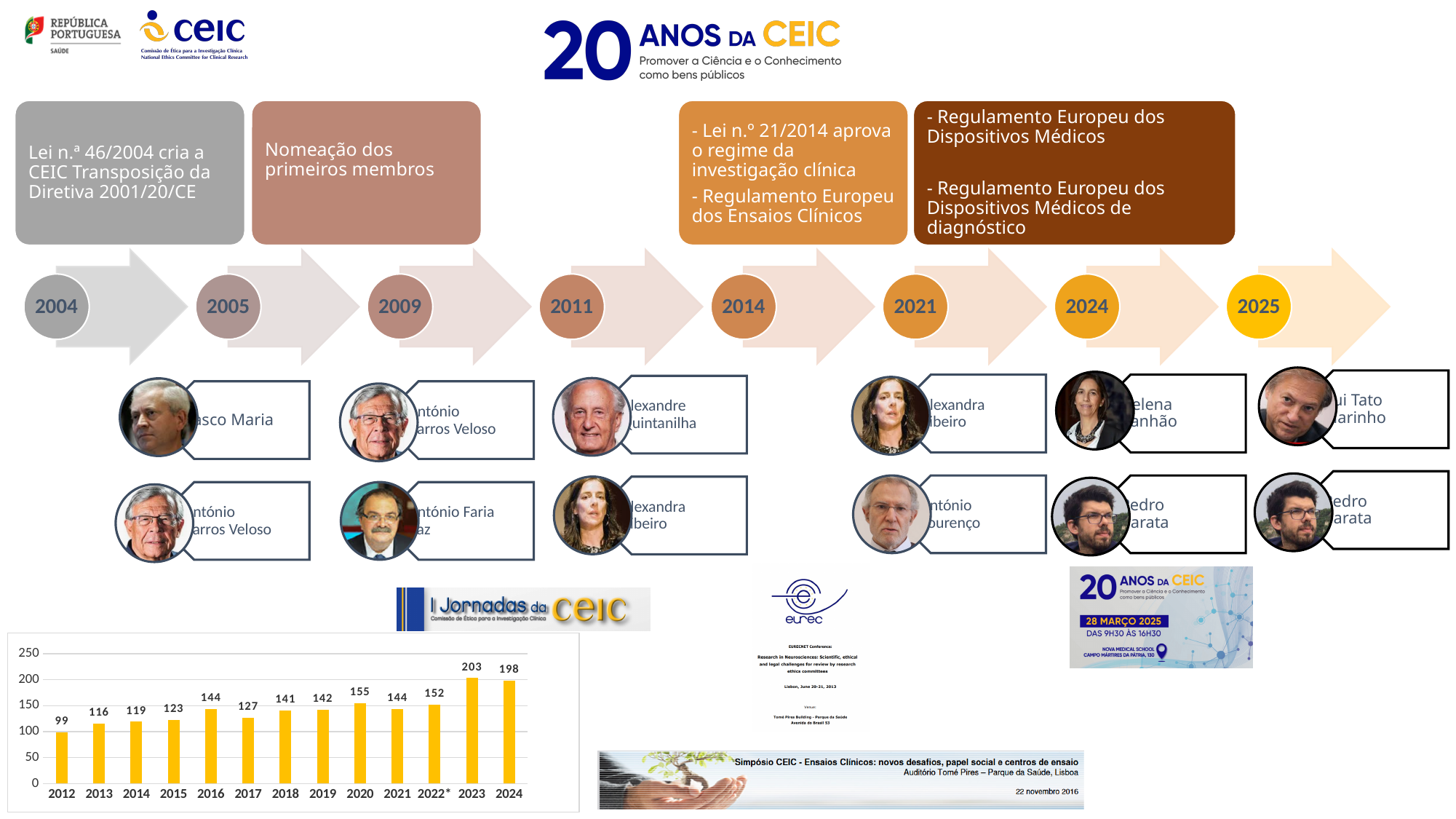
What is the highest tick value on the y axis of the bar chart? 250 Is the value for 2023 in the bar chart greater or less than 200? greater What is the difference between the values for 2023 and 2024 in the bar chart? 5 How many years are shown on the x axis of the bar chart? 13 What is the value shown for 2012 in the bar chart at the bottom left of the slide? 99 Which year has the lowest value in the bar chart? 2012 What is the value shown for 2020 in the bar chart? 155 What is the difference between the values for 2016 and 2017 in the bar chart? 17 In the bar chart, which is larger, the value for 2020 or the value for 2021? 2020 What is the value shown for 2022* in the bar chart? 152 Which year has the highest value in the bar chart? 2023 What kind of chart is shown at the bottom left of the slide? bar chart